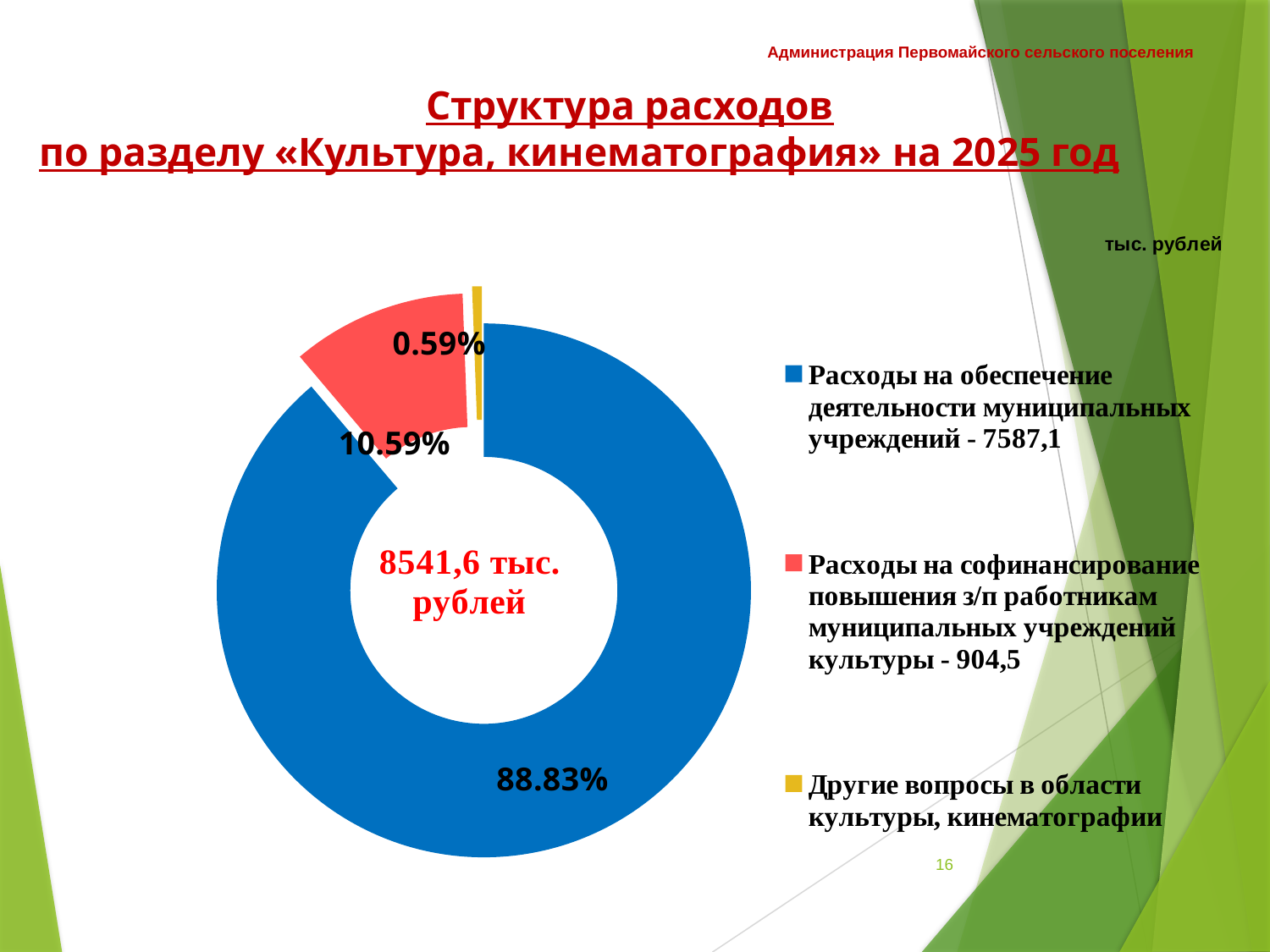
What share of the chart does «Расходы на обеспечение деятельности муниципальных учреждений» represent? 88.83% What is the value (тыс. рублей) shown in the legend for «Расходы на софинансирование повышения з/п работникам муниципальных учреждений культуры»? 904,5 What is the difference in percentage points between the 88.83% slice and the 10.59% slice? 78.24 What total amount is shown in the centre of the chart? 8541,6 тыс. рублей Which is larger: the slice for «Расходы на софинансирование повышения з/п работникам муниципальных учреждений культуры» or the slice for «Другие вопросы в области культуры, кинематографии»? Расходы на софинансирование повышения з/п работникам муниципальных учреждений культуры Which category has the smallest slice of the chart? Другие вопросы в области культуры, кинематографии What share of the chart does «Расходы на софинансирование повышения з/п работникам муниципальных учреждений культуры» represent? 10.59% What is the value (тыс. рублей) shown in the legend for «Расходы на обеспечение деятельности муниципальных учреждений»? 7587,1 What kind of chart is shown on the slide? Doughnut (pie) chart What share of the chart does «Другие вопросы в области культуры, кинематографии» represent? 0.59% Which category has the largest slice of the chart? Расходы на обеспечение деятельности муниципальных учреждений How many categories does the chart show? 3